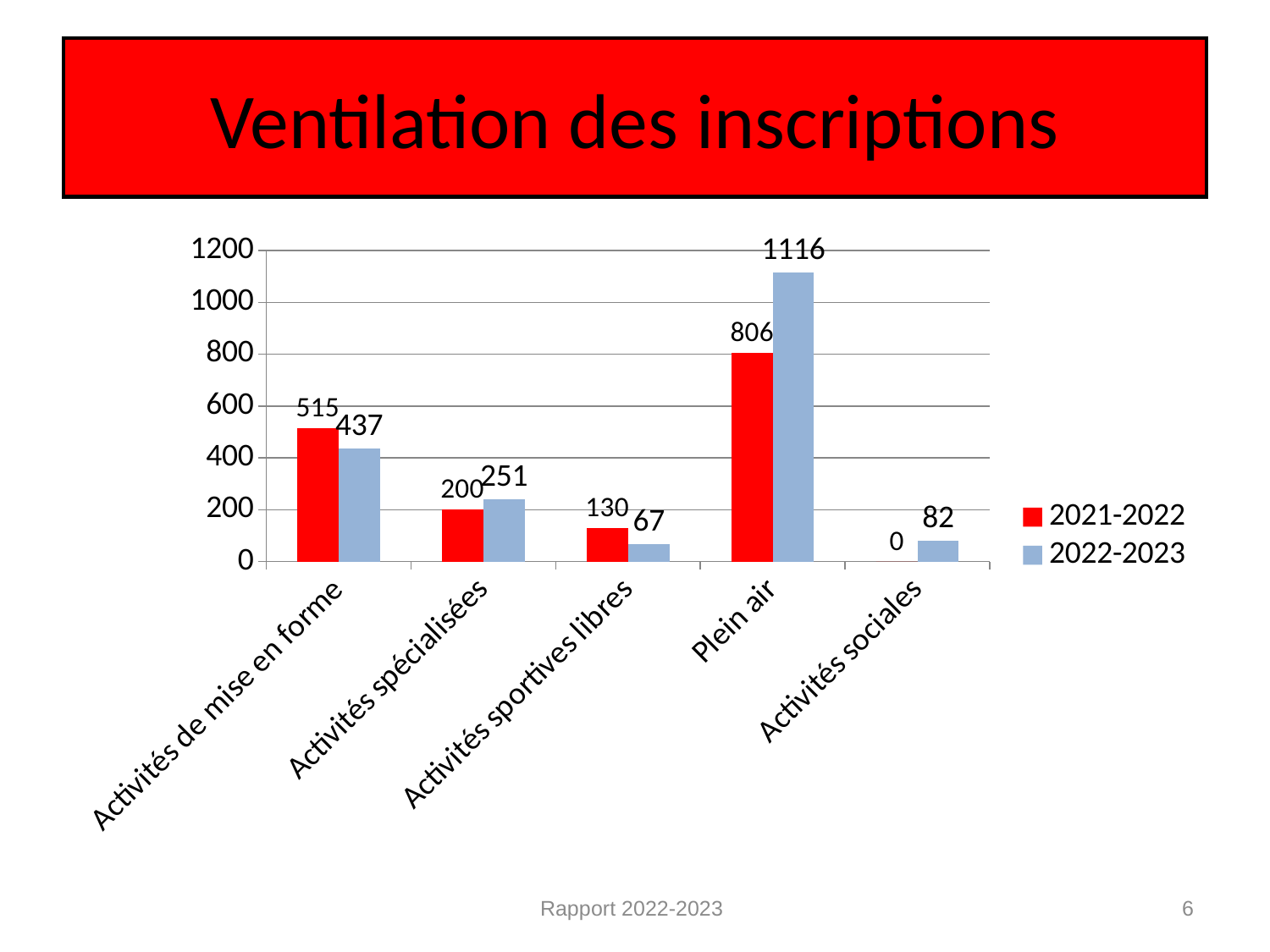
For Activités spécialisées, which series has the larger value, 2021-2022 or 2022-2023? 2022-2023 What is the value for Activités sociales in the 2021-2022 series? 0 Which category has the lowest value in the 2022-2023 series? Activités sportives libres What is the difference between the 2022-2023 and 2021-2022 values for Plein air? 310 What is the difference between the 2021-2022 and 2022-2023 values for Activités de mise en forme? 78 What is the value for Plein air in the 2022-2023 series? 1116 Is the 2021-2022 value for Plein air greater or less than 1000? less What is the value for Activités de mise en forme in the 2021-2022 series? 515 How many series does the legend list? 2 Which category has the highest value in the 2021-2022 series? Plein air How many categories are shown on the x axis? 5 What kind of chart is shown on the slide? bar chart